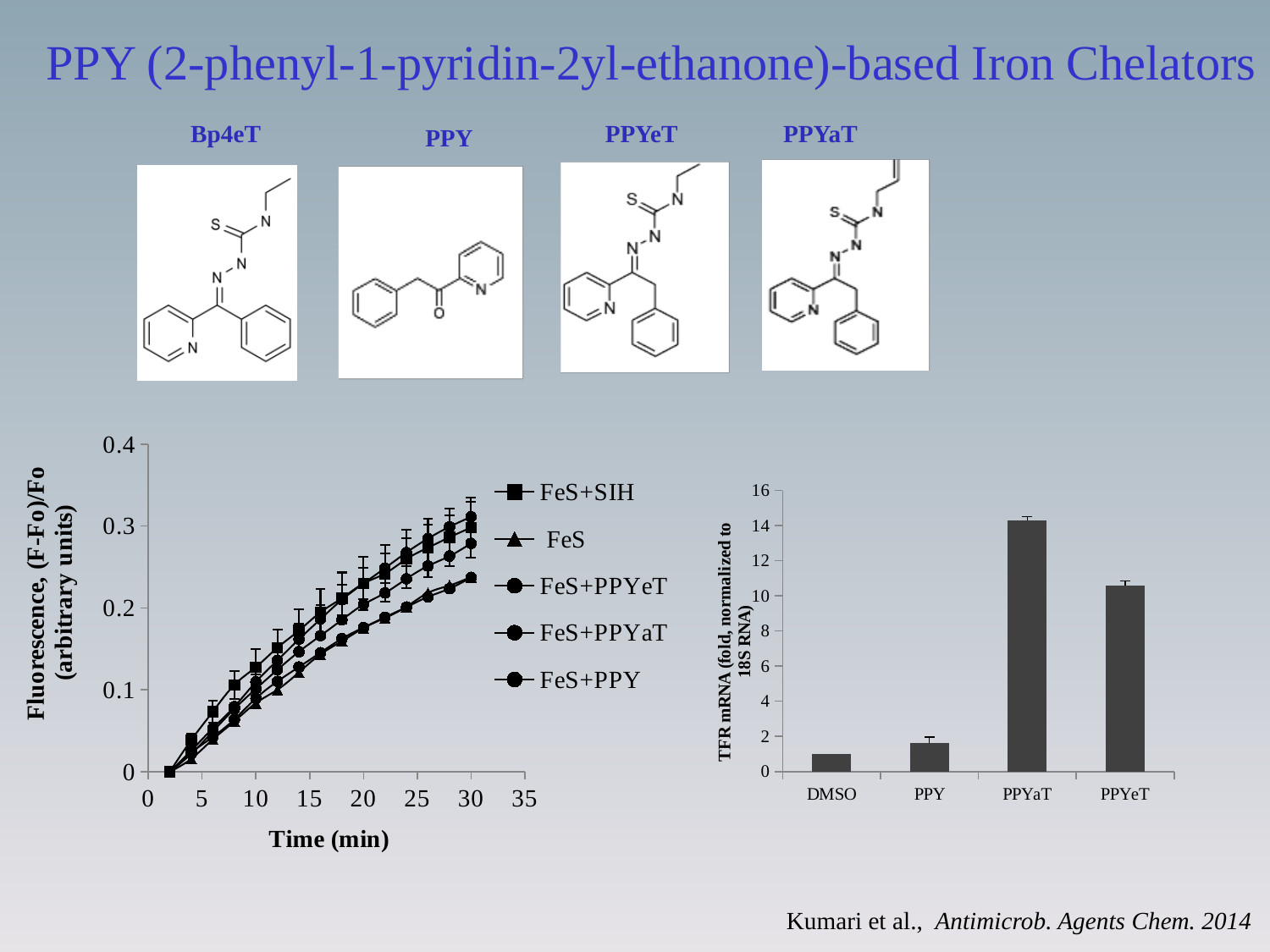
How many series does the legend of the left chart (Fluorescence vs Time) list? 5 What is the x-axis label of the left chart? Time (min) In the bar chart on the right, is the value for PPYaT greater or less than 12? greater In the bar chart on the right, is the value for DMSO greater or less than 2? less What kind of chart is the chart on the left of the slide (Fluorescence vs Time)? line chart In the bar chart on the right, is the value for PPYeT greater or less than 8? greater What kind of chart is the chart on the right of the slide? bar chart In the bar chart on the right, which bar is taller, PPYaT or PPYeT? PPYaT In the left chart (Fluorescence vs Time), do the fluorescence values rise or fall as time increases? rise In the bar chart on the right, which category has the highest TFR mRNA value? PPYaT How many categories are shown in the bar chart on the right? 4